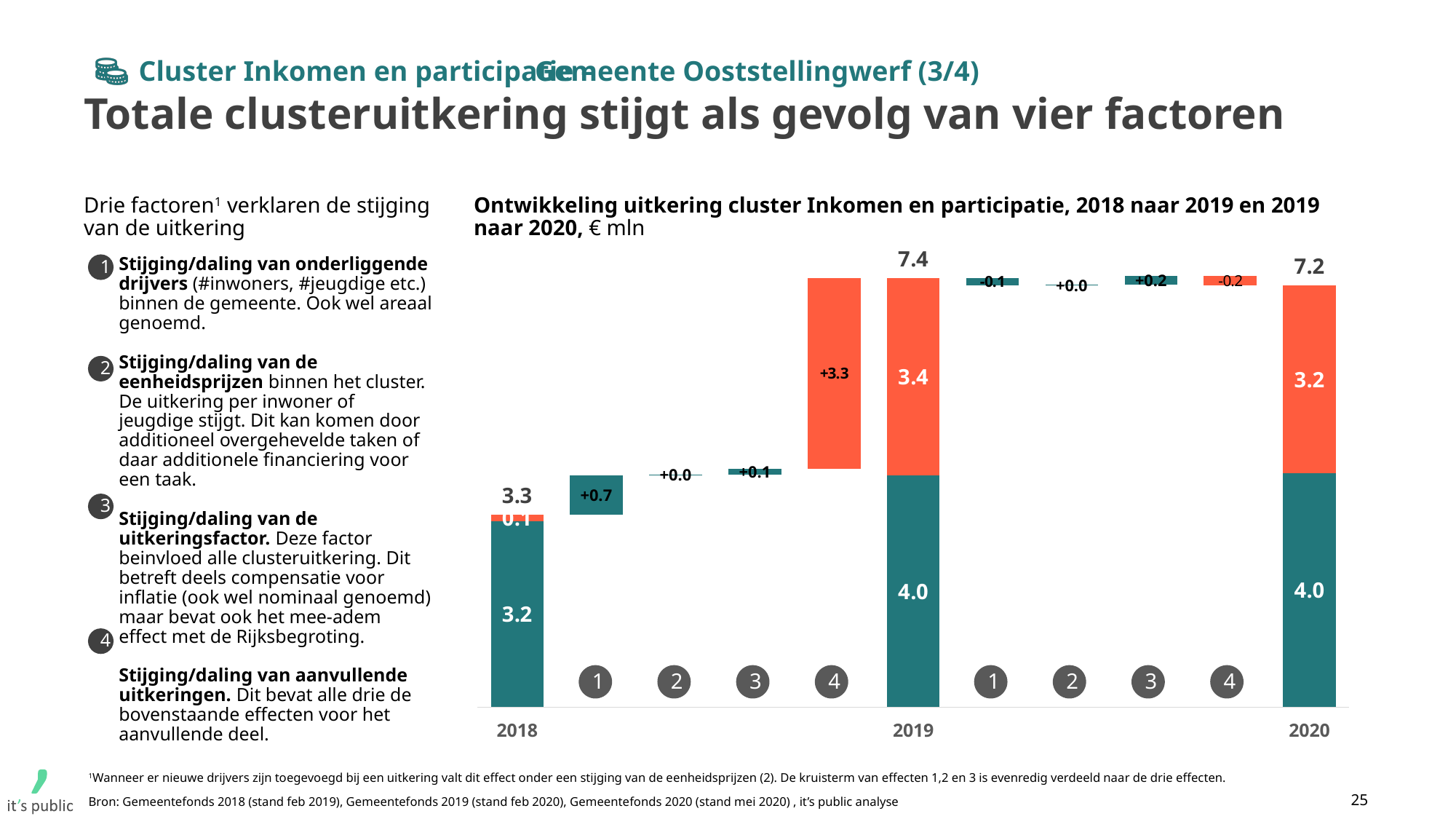
What is the total cluster payout shown for 2020? 7.2 Is the 2020 total larger or smaller than the 2019 total? smaller What is the value of factor 4 in the step from 2018 to 2019? +3.3 What is the value of factor 4 in the step from 2019 to 2020? -0.2 Which year has the highest total cluster payout? 2019 What is the total cluster payout shown for 2019? 7.4 In what unit are the values in the chart expressed? € mln What is the value of factor 1 in the step from 2018 to 2019? +0.7 What is the difference between the 2019 total and the 2018 total? 4.1 What is the value of the orange segment in the 2019 bar? 3.4 What is the total cluster payout shown for 2018? 3.3 What is the value of the teal segment in the 2020 bar? 4.0